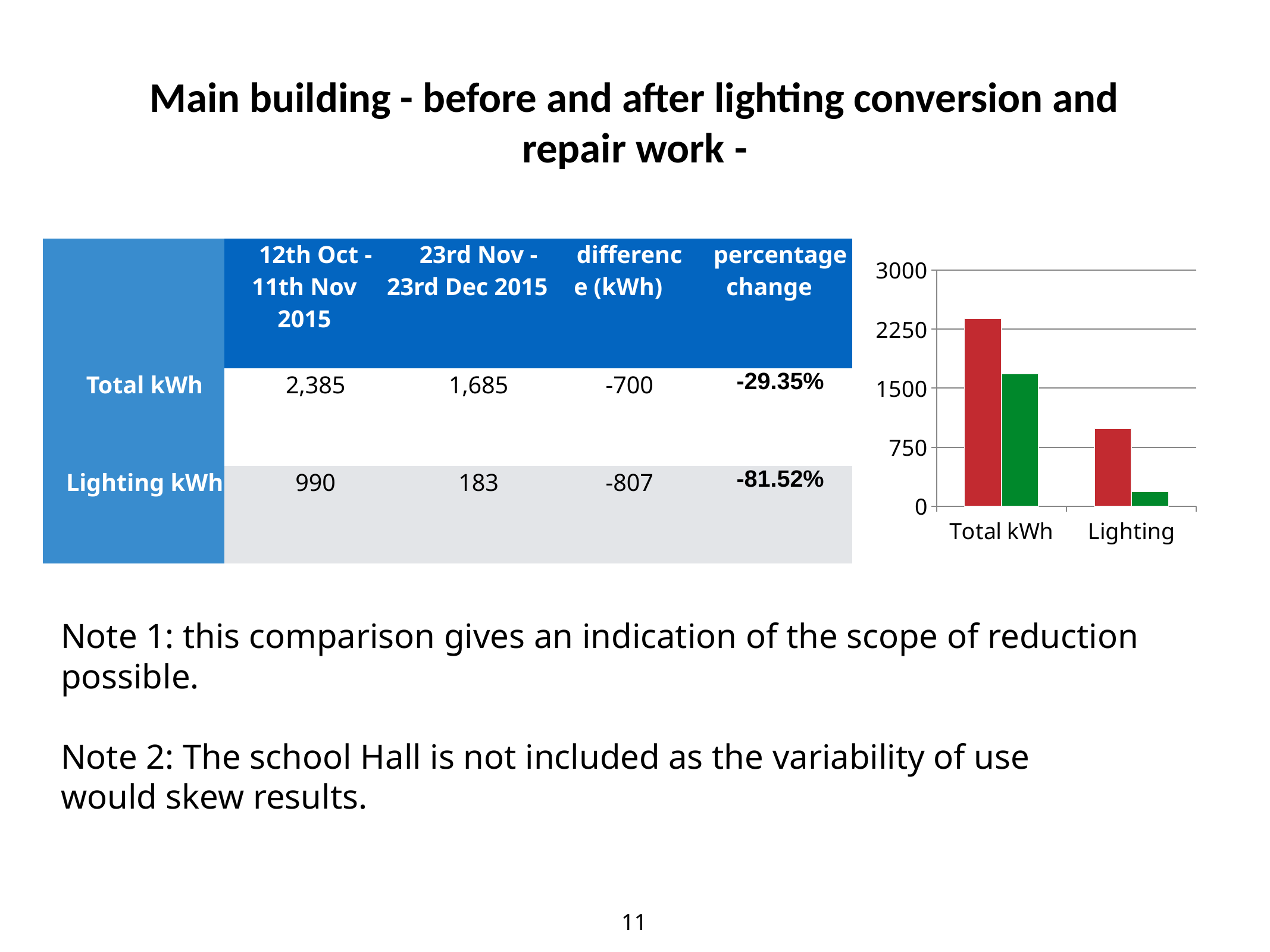
In the bar chart, which bar is the shortest? the green bar for Lighting In the bar chart, is the green bar for Total kWh greater or less than 1500? greater In the bar chart, which category has the tallest bar? Total kWh In the bar chart, is the red bar for Total kWh greater or less than 2250? greater What is the highest value shown on the y axis of the bar chart? 3000 What kind of chart is shown on the right of the slide? bar chart In the bar chart, is the red bar for Lighting greater or less than 750? greater In the bar chart, which is larger for Lighting: the red bar or the green bar? the red bar In the bar chart, is the green bar for Total kWh larger or smaller than the red bar for Lighting? larger How many categories are shown on the x axis of the bar chart? 2 What two colours are the bars in the chart? red and green